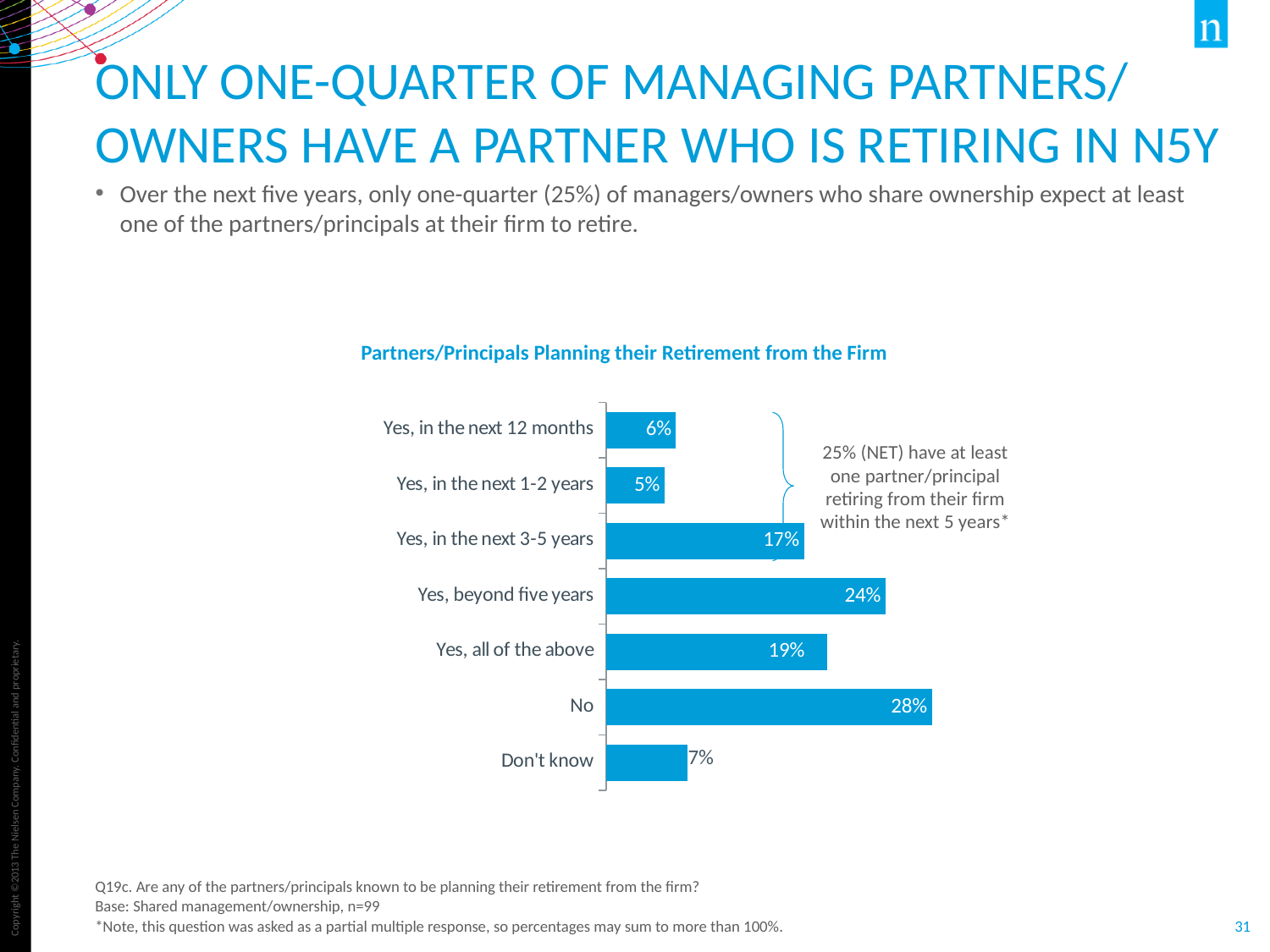
Which is larger: "Yes, in the next 3-5 years" or "Yes, all of the above"? Yes, all of the above What is the value for "Don't know"? 7% According to the annotation on the chart, what percentage (NET) have at least one partner/principal retiring within the next 5 years? 25% What is the title of the chart? Partners/Principals Planning their Retirement from the Firm What is the value for "Yes, in the next 3-5 years"? 17% Which category has the lowest value? Yes, in the next 1-2 years What kind of chart is shown on the slide? Bar chart What is the value for "Yes, in the next 12 months"? 6% What is the difference between "Yes, beyond five years" and "Yes, all of the above"? 5% What is the value for "No"? 28% How many categories are shown in the chart? 7 Which category has the highest value? No